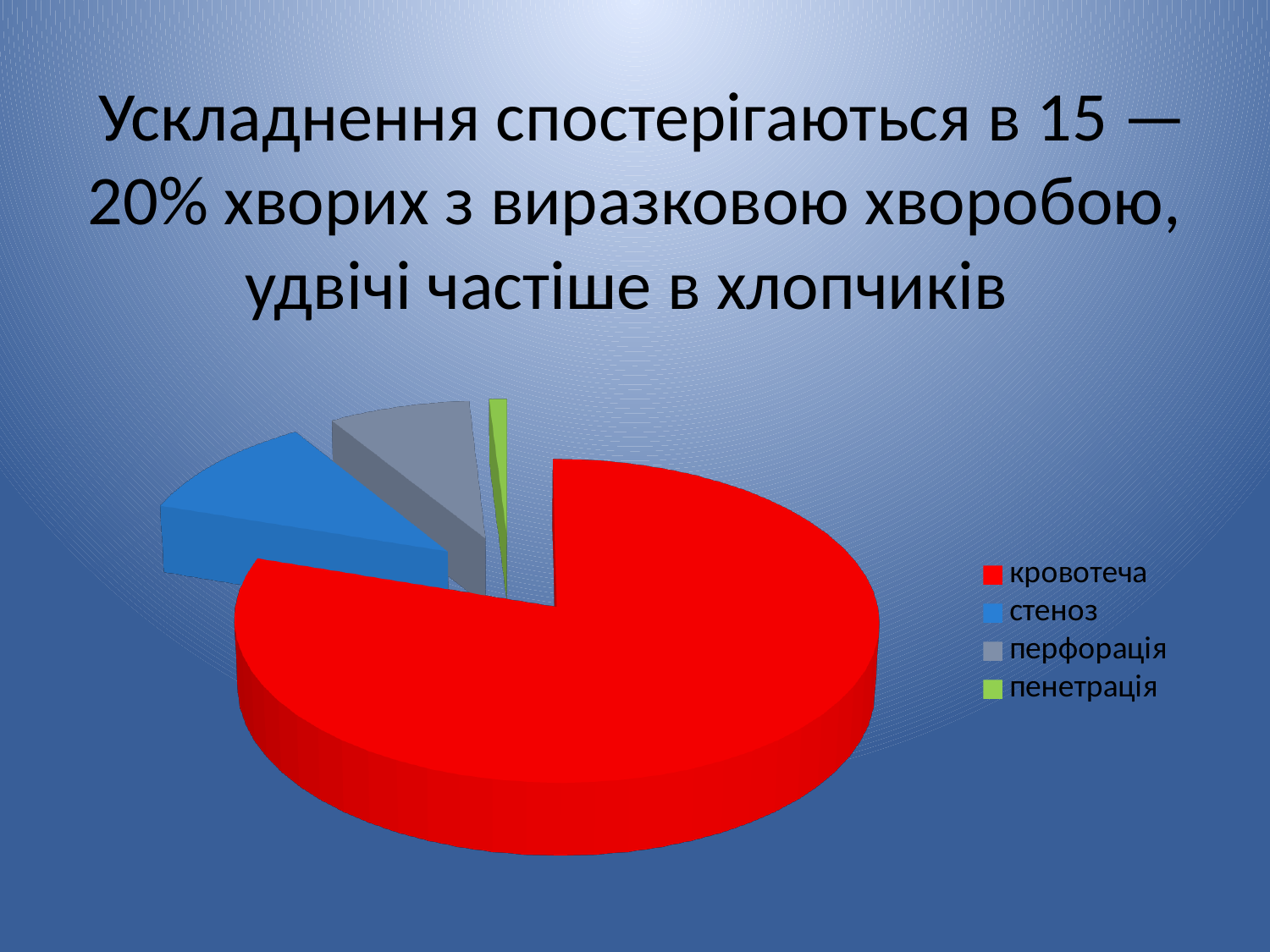
How many slices does the pie chart have? 4 Which category is shown in green in the legend? пенетрація Which slice is larger, кровотеча or стеноз? кровотеча Which category has the largest slice of the pie? кровотеча Which category has the smallest slice of the pie? пенетрація How many entries does the legend list? 4 Which slice is larger, перфорація or пенетрація? перфорація What colour is the slice for кровотеча? red Which slice is larger, стеноз or пенетрація? стеноз What kind of chart is shown on the slide? pie chart